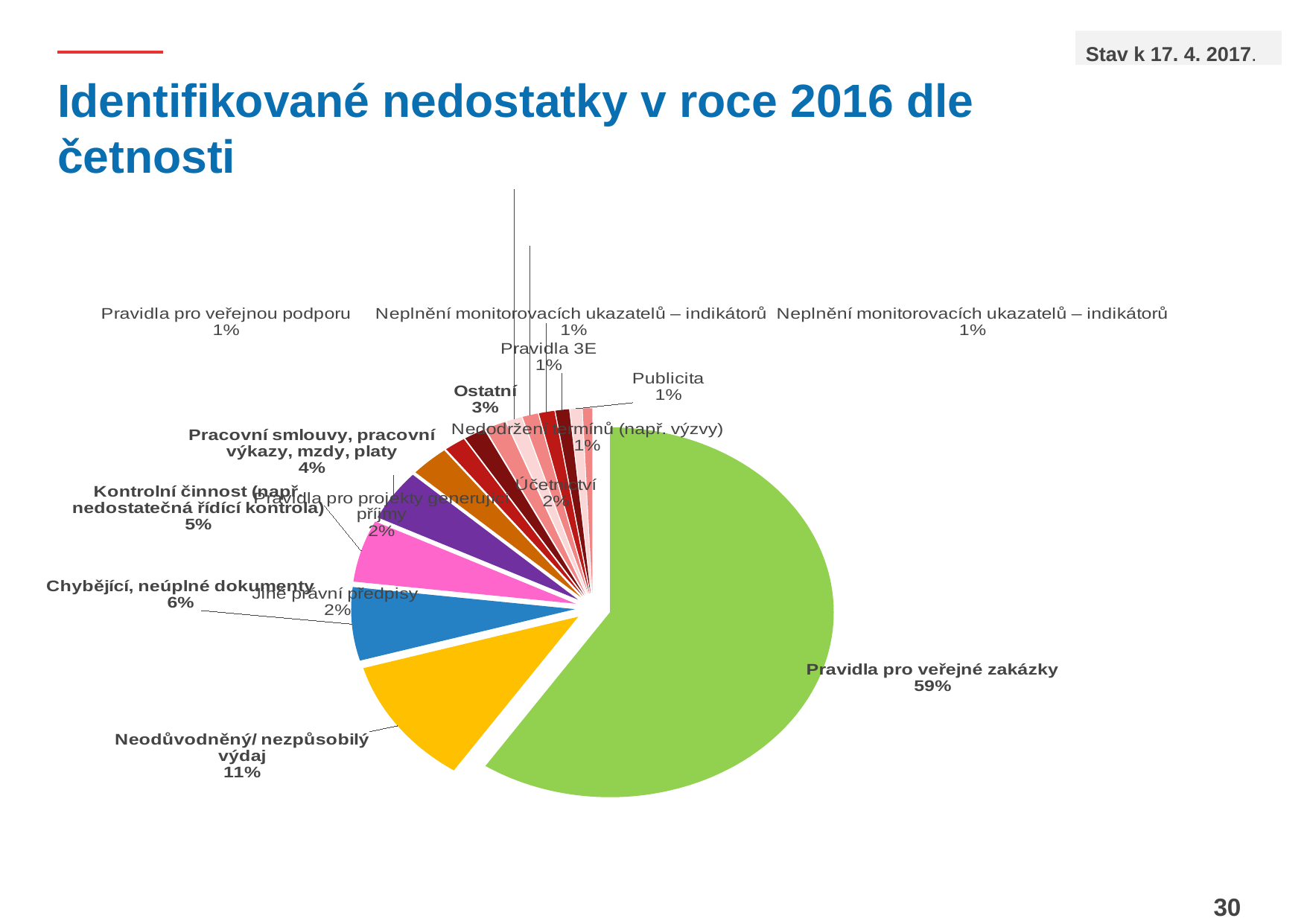
What is the value shown for "Chybějící, neúplné dokumenty"? 6% What is the value shown for "Kontrolní činnost (např. nedostatečná řídící kontrola)"? 5% What is the value shown for "Ostatní"? 3% Which is larger, the share for "Chybějící, neúplné dokumenty" or the share for "Ostatní"? Chybějící, neúplné dokumenty What share of the pie does "Pravidla pro veřejné zakázky" represent? 59% What is the title of the chart on the slide? Identifikované nedostatky v roce 2016 dle četnosti Which category has the largest share of the pie? Pravidla pro veřejné zakázky What kind of chart is shown on the slide? pie chart What is the value shown for "Pracovní smlouvy, pracovní výkazy, mzdy, platy"? 4% What is the difference between the shares of "Pravidla pro veřejné zakázky" and "Neodůvodněný/ nezpůsobilý výdaj"? 48% What is the value shown for "Neodůvodněný/ nezpůsobilý výdaj"? 11% What is the value shown for "Publicita"? 1%